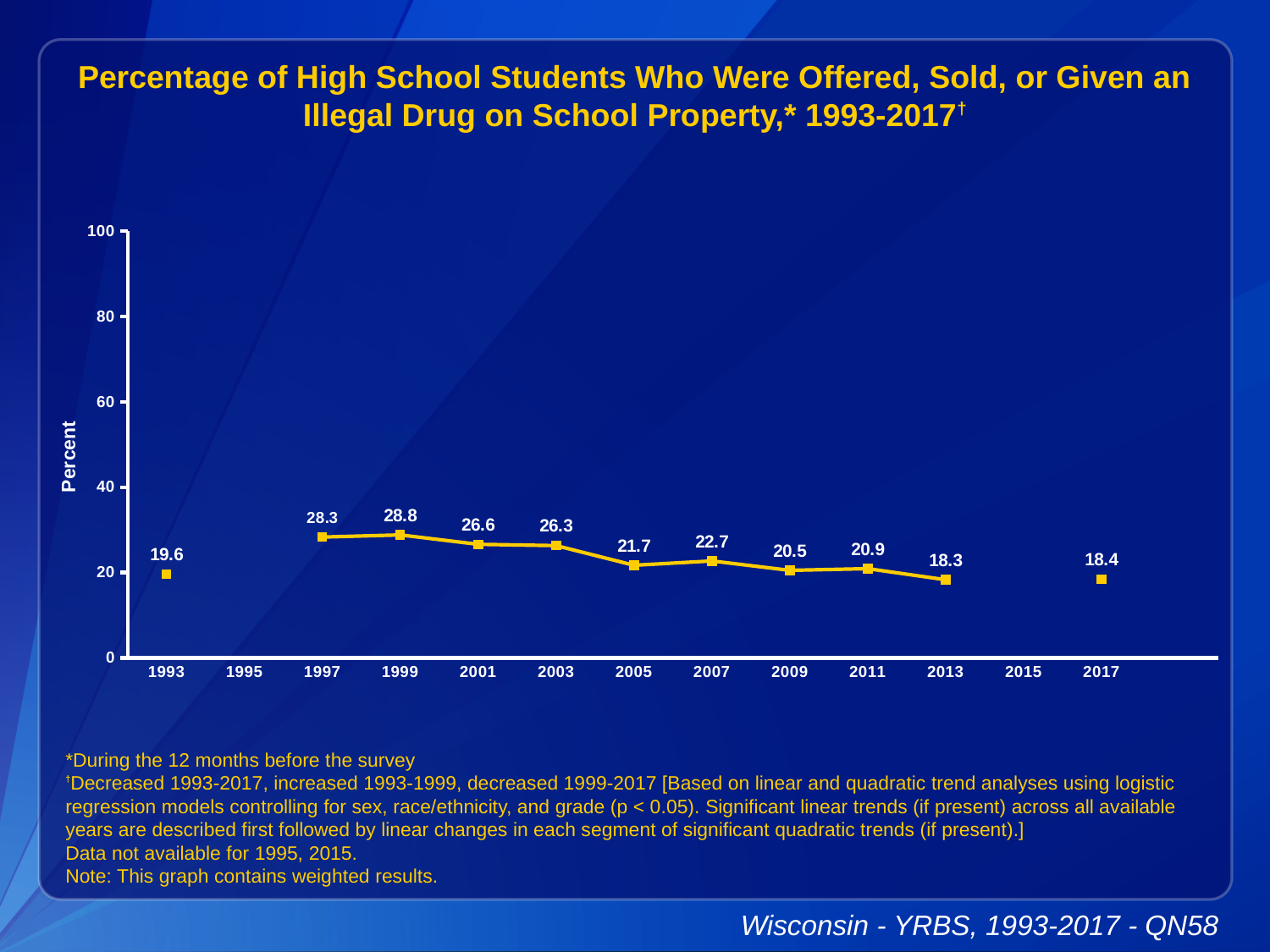
What was the percentage of high school students who were offered, sold, or given an illegal drug on school property in 1993? 19.6 Do the values rise or fall from 1999 to 2013? fall Which year has the highest value on the chart? 1999 What is the label on the vertical axis? Percent How many years have data points plotted on the chart? 11 What kind of chart is shown on the slide? line chart Which year has a larger value, 2007 or 2009? 2007 What is the difference between the values for 1999 and 2013? 10.5 Which year has the lowest value on the chart? 2013 Is the value for 2001 greater or less than 20? greater What value is shown for 2005? 21.7 What value is shown for 2017? 18.4